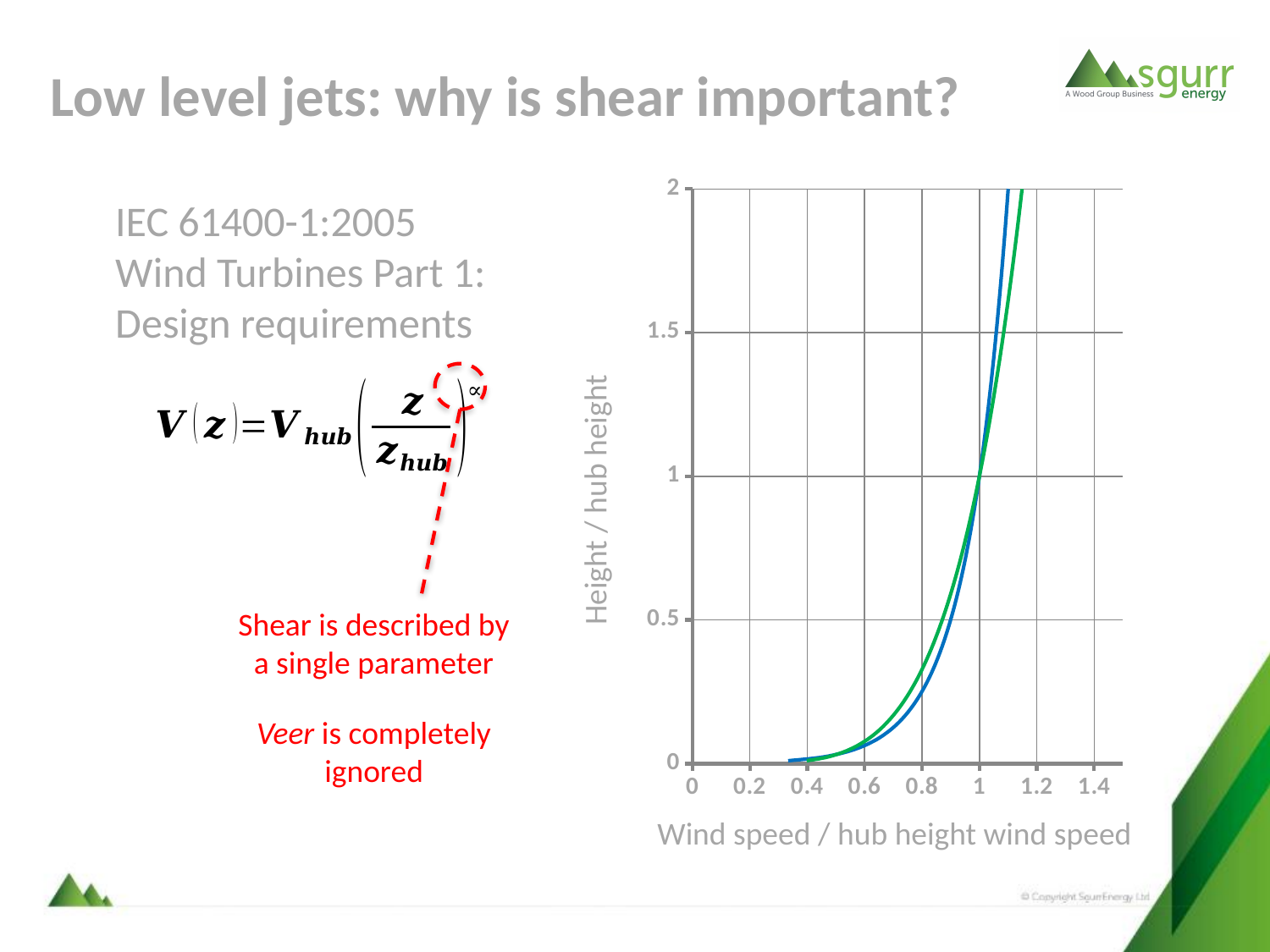
What is the label of the y axis of the chart? Height / hub height What is the label of the x axis of the chart? Wind speed / hub height wind speed At what value of Height / hub height do the two curves cross? 1 How many curves are plotted on the chart? 2 At a Height / hub height of 1.5, is the wind speed ratio on the green curve greater or less than 1? greater What kind of chart is shown on the slide? line chart At a Height / hub height of 0.5, is the wind speed ratio on the blue curve greater or less than 0.6? greater At what value of Wind speed / hub height wind speed do the two curves cross? 1 What is the highest value shown on the x axis of the chart? 1.4 As Wind speed / hub height wind speed increases along the x axis, does Height / hub height rise or fall? rise At a Height / hub height of 2, is the wind speed ratio on the blue curve greater or less than 1.2? less How many tick labels are shown on the y axis of the chart? 5